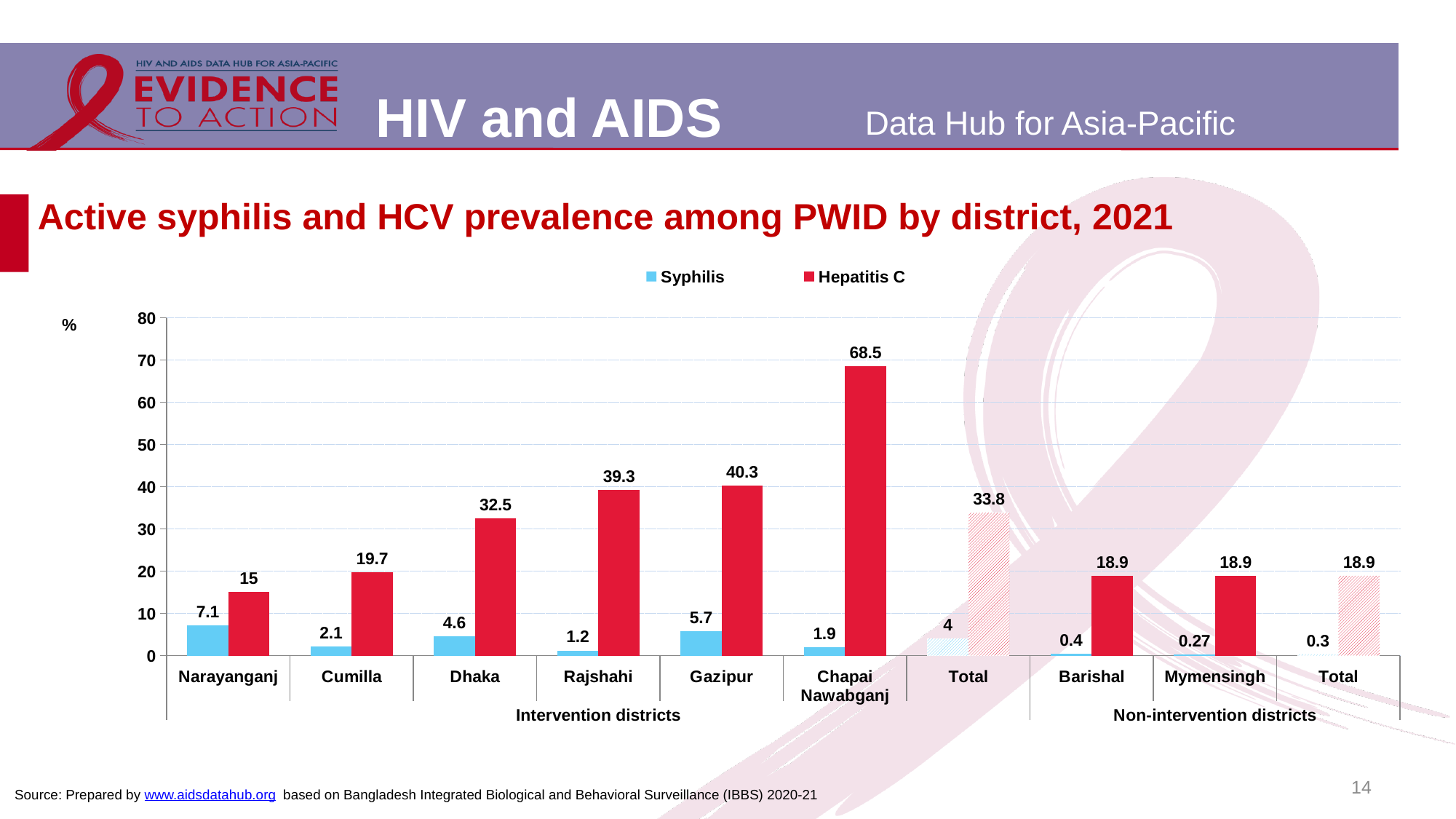
Which district has the highest Hepatitis C prevalence? Chapai Nawabganj Is the Hepatitis C value for Chapai Nawabganj greater or less than 60? greater What is the Syphilis value for Mymensingh? 0.27 Which is larger, the Hepatitis C value for Dhaka or for Cumilla? Dhaka How many series does the legend list? 2 What is the difference between the Hepatitis C values for Gazipur and Rajshahi? 1 What is the title of the chart? Active syphilis and HCV prevalence among PWID by district, 2021 What kind of chart is shown on the slide? Bar chart What is the Hepatitis C prevalence for Chapai Nawabganj? 68.5 Which district has the lowest Syphilis prevalence? Mymensingh What is the Syphilis prevalence for Narayanganj? 7.1 What is the Hepatitis C value for the Total of the intervention districts? 33.8